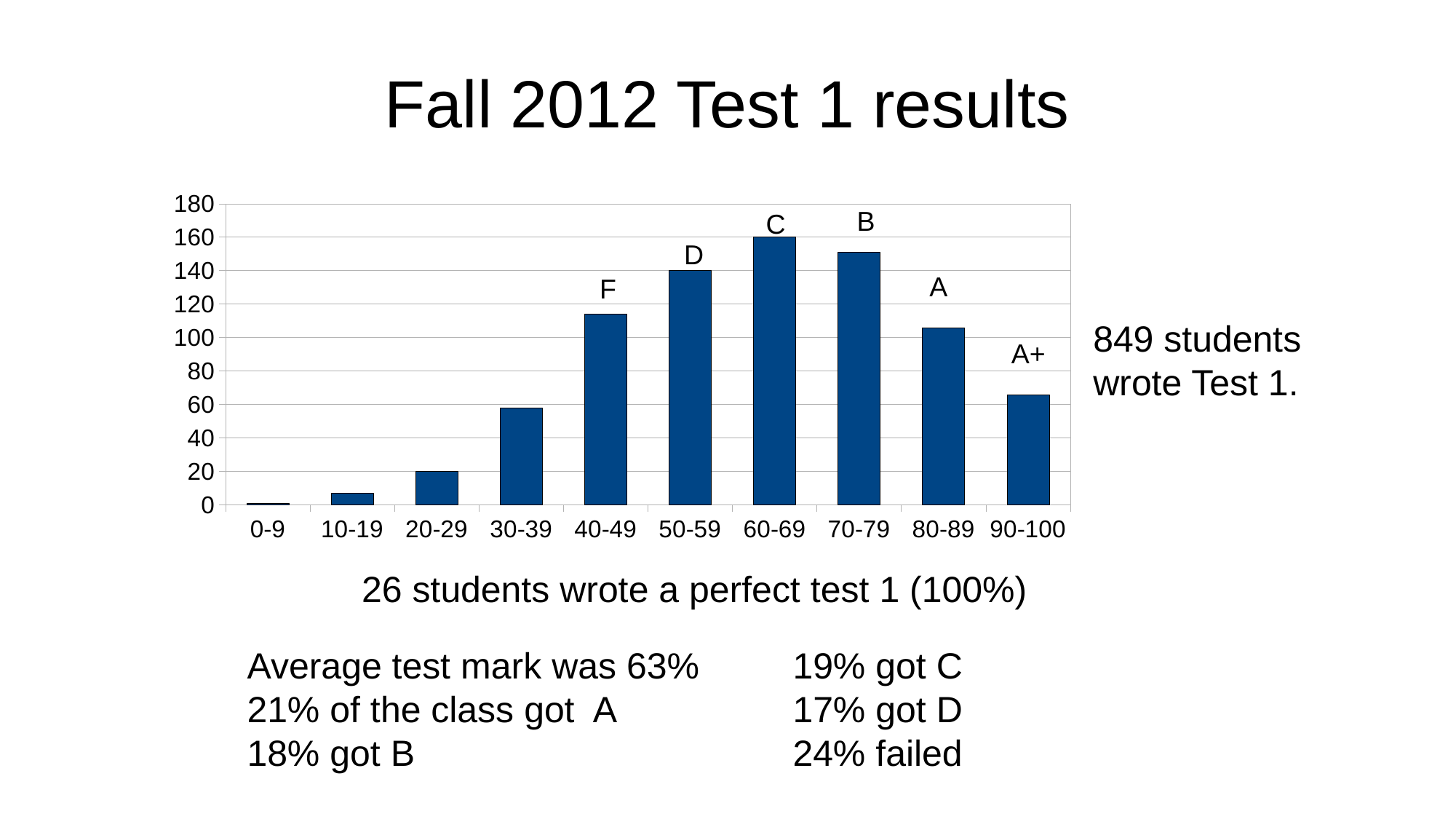
What kind of chart is shown on the slide? bar chart Is the value for the 40-49 score range greater or less than 100? greater Which score range has a higher bar, 70-79 or 80-89? 70-79 Which score range has the highest bar in the chart? 60-69 What is the title of the slide containing the chart? Fall 2012 Test 1 results Is the value for the 70-79 score range greater or less than 140? greater Which score range has a higher bar, 30-39 or 90-100? 90-100 Is the value for the 90-100 score range greater or less than 80? less Which score range has the lowest bar in the chart? 0-9 Do the bar values rise or fall from the 0-9 range to the 60-69 range? rise How many score ranges (categories) are shown on the x axis of the chart? 10